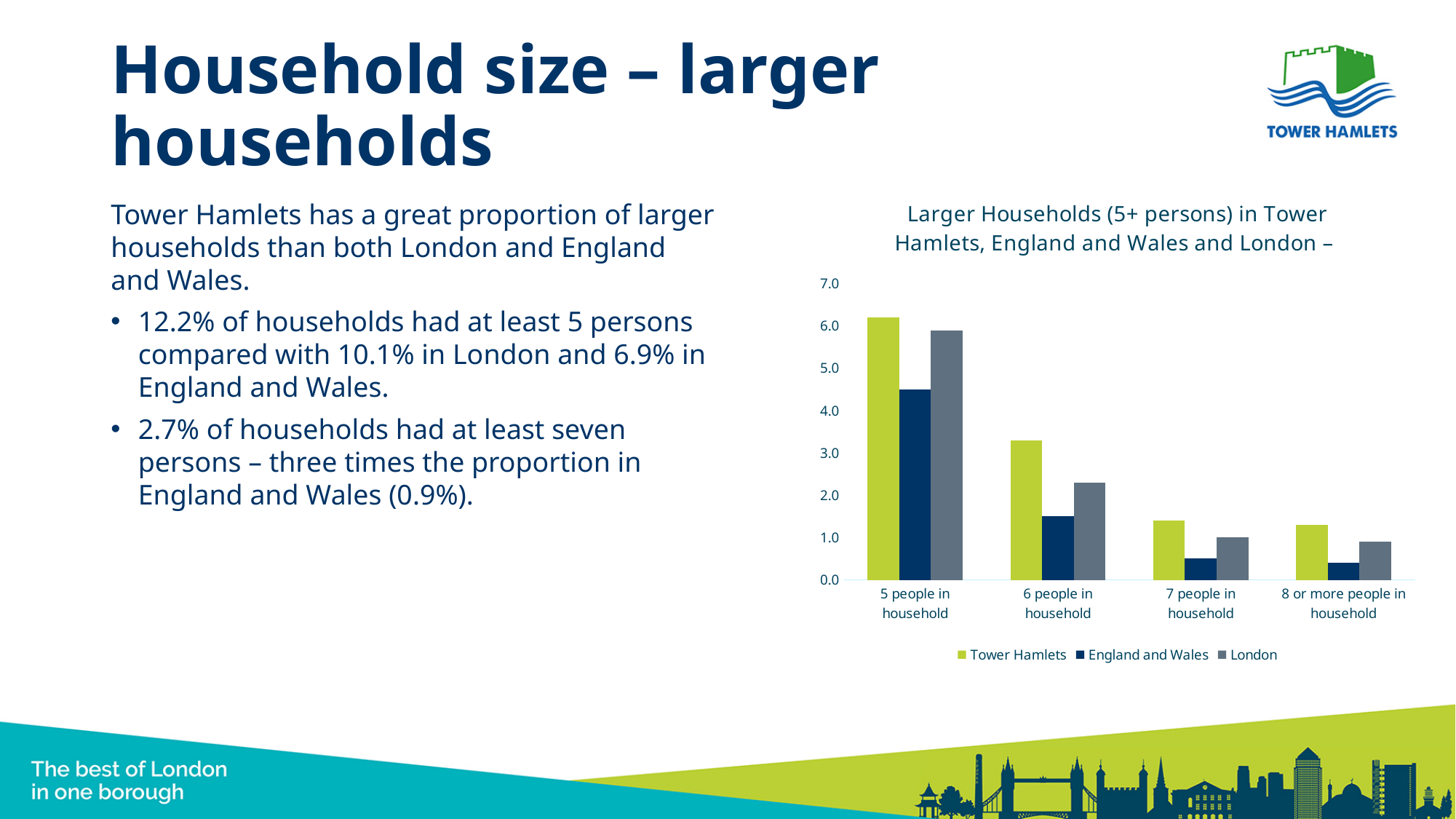
Which series is shown in green in the chart's legend? Tower Hamlets What kind of chart is shown on the slide? Bar chart How many household-size categories are shown on the x axis of the chart? 4 Do the Tower Hamlets values rise or fall as you move from '5 people in household' to '8 or more people in household'? fall How many series does the chart's legend list? 3 Which series has the tallest bar in the '5 people in household' category? Tower Hamlets Which series has the lowest bar in the '8 or more people in household' category? England and Wales Is the value for England and Wales in the '6 people in household' category greater or less than 2.0? less Is the value for England and Wales in the '7 people in household' category greater or less than 1.0? less Is the value for Tower Hamlets in the '5 people in household' category greater or less than 5.0? greater For the '5 people in household' category, which is larger: the value for England and Wales or the value for London? London